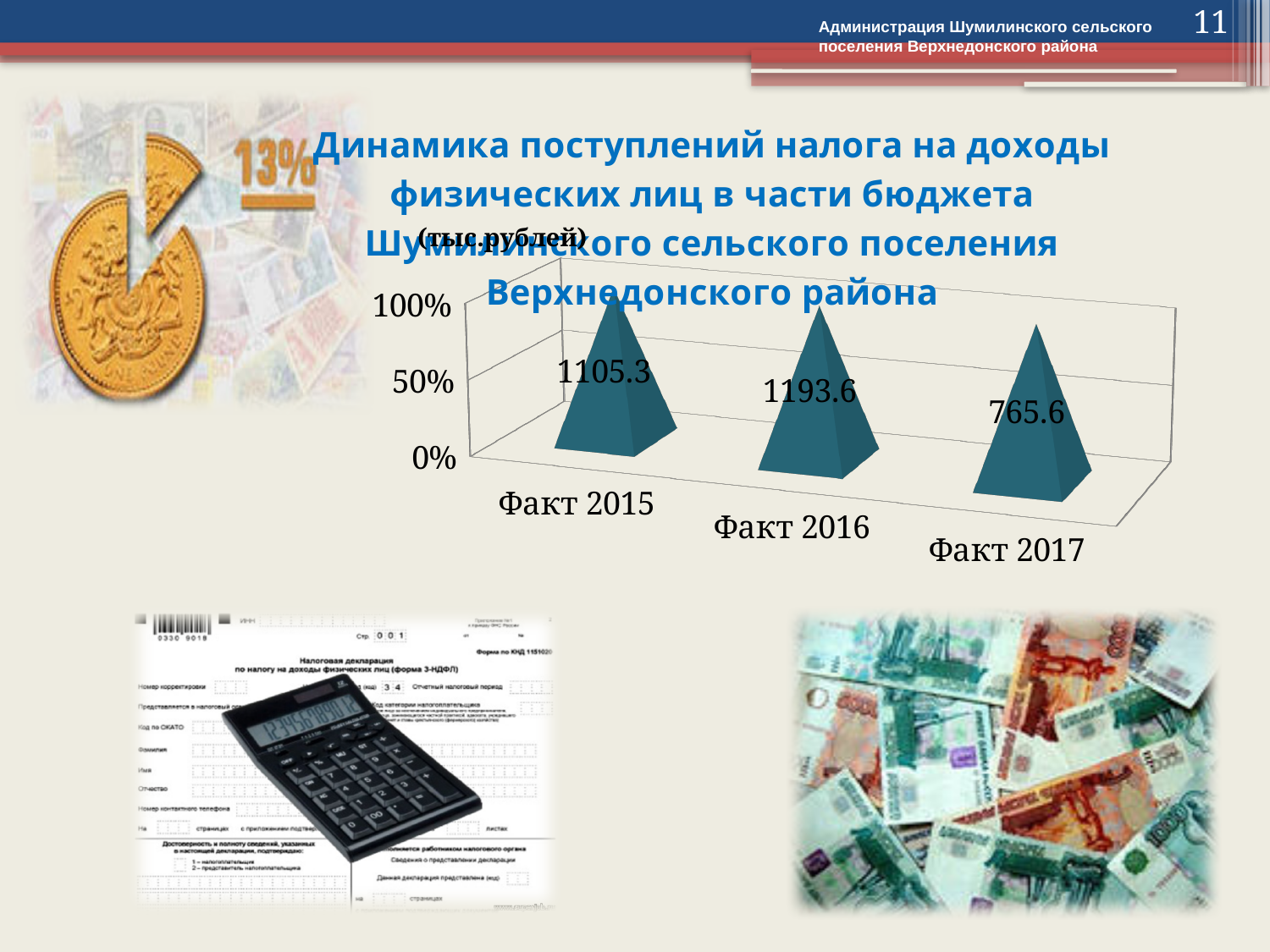
What is the difference between the values for Факт 2016 and Факт 2017? 428.0 Does the value rise or fall from Факт 2016 to Факт 2017? Fall What is the value for Факт 2016? 1193.6 What is the difference between the values for Факт 2015 and Факт 2017? 339.7 How many categories are shown on the chart? 3 Which category has the lowest value? Факт 2017 What is the value for Факт 2015? 1105.3 What is the difference between the values for Факт 2016 and Факт 2015? 88.3 What kind of chart is shown on the slide? Bar chart Which is larger, the value for Факт 2015 or the value for Факт 2017? Факт 2015 What is the value for Факт 2017? 765.6 Which category has the highest value? Факт 2016